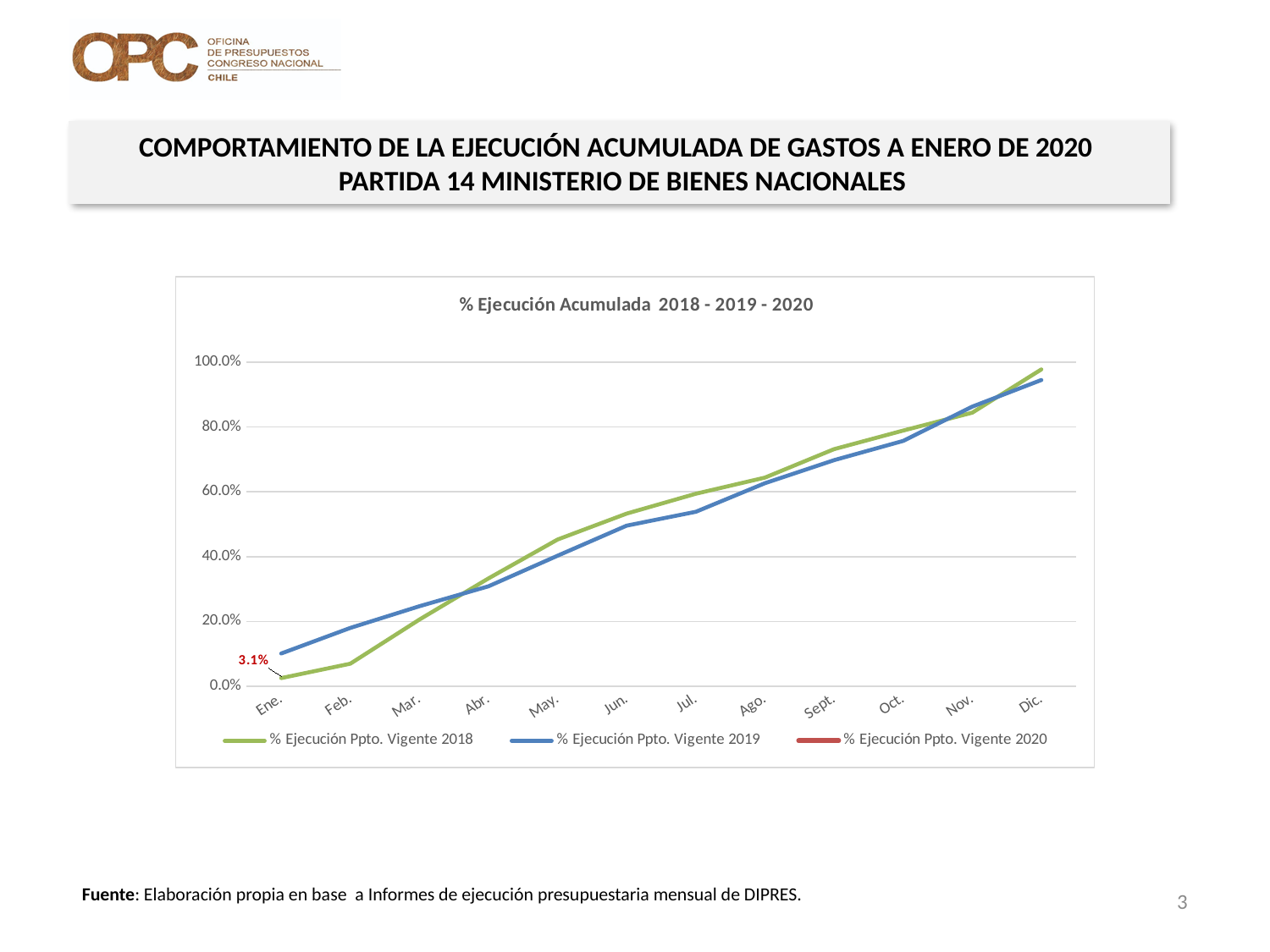
In which month does the % Ejecución Ppto. Vigente 2019 line reach its highest value? Dic. Is the value for % Ejecución Ppto. Vigente 2019 in Dic. greater or less than 80.0%? greater How many series does the chart legend list? 3 What is the only data label printed on the chart? 3.1% Is the value for % Ejecución Ppto. Vigente 2019 in Oct. greater or less than 60.0%? greater How many months are shown along the x axis of the chart? 12 Does the % Ejecución Ppto. Vigente 2019 line rise or fall from Ene. to Dic.? rise In Feb., which series has the larger value: % Ejecución Ppto. Vigente 2018 or % Ejecución Ppto. Vigente 2019? % Ejecución Ppto. Vigente 2019 Is the value for % Ejecución Ppto. Vigente 2018 in Feb. greater or less than 20.0%? less What kind of chart is shown on the slide? line chart What is the title of the chart? % Ejecución Acumulada 2018 - 2019 - 2020